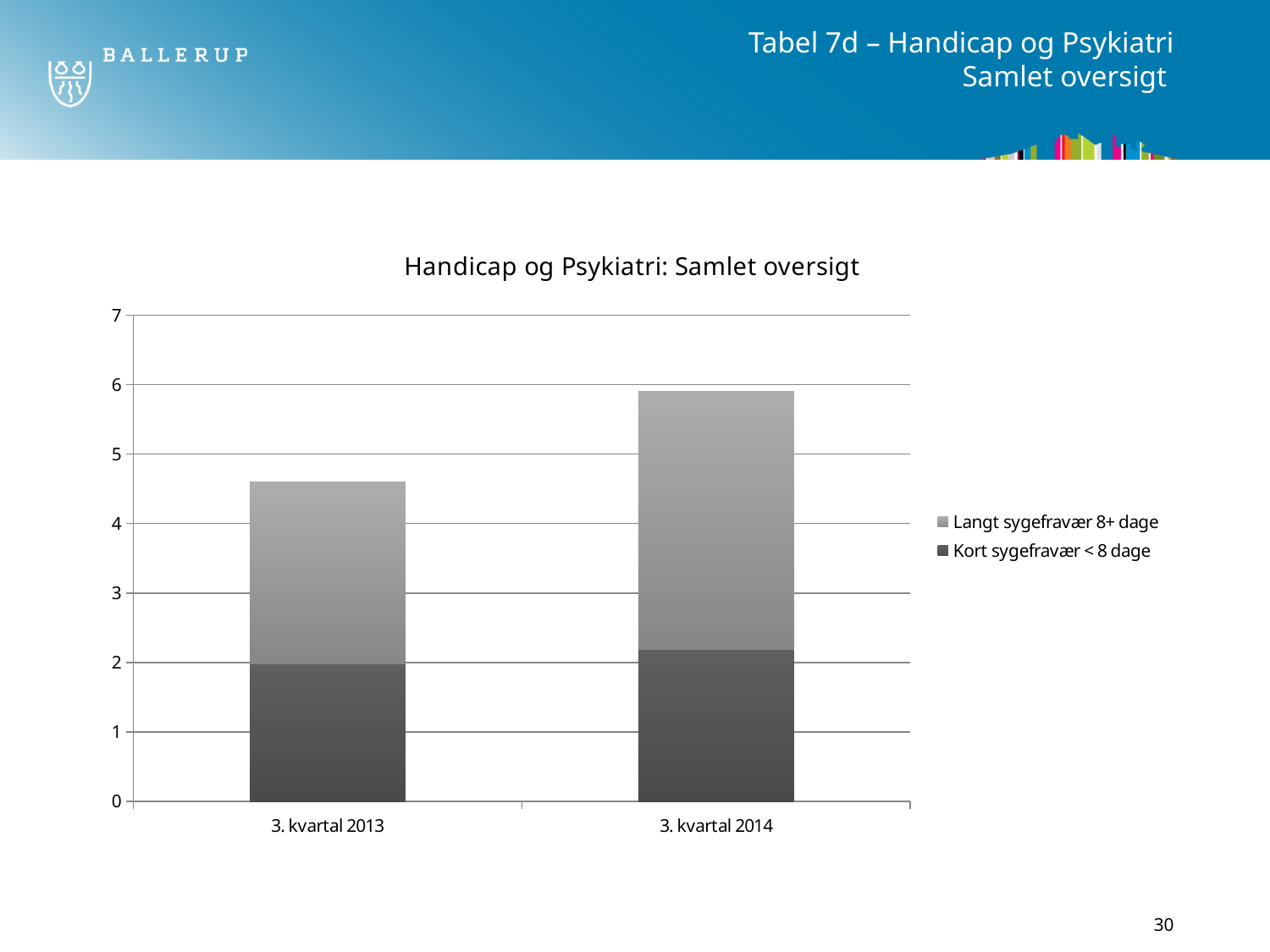
What kind of chart is shown on the slide? Stacked bar chart Is the total stacked value for 3. kvartal 2013 greater or less than 5? less How many categories are shown on the x axis? 2 Which category has the shorter stacked bar overall? 3. kvartal 2013 What is the title of the chart? Handicap og Psykiatri: Samlet oversigt Which category has the taller stacked bar overall? 3. kvartal 2014 How many series does the legend list? 2 Is the total stacked value for 3. kvartal 2014 greater or less than 5? greater Is the Langt sygefravær 8+ dage segment larger for 3. kvartal 2013 or 3. kvartal 2014? 3. kvartal 2014 Which series is shown in the darker colour at the bottom of each bar? Kort sygefravær < 8 dage Is the total stacked value for 3. kvartal 2013 greater or less than 4? greater Does the total stacked value rise or fall from 3. kvartal 2013 to 3. kvartal 2014? rise